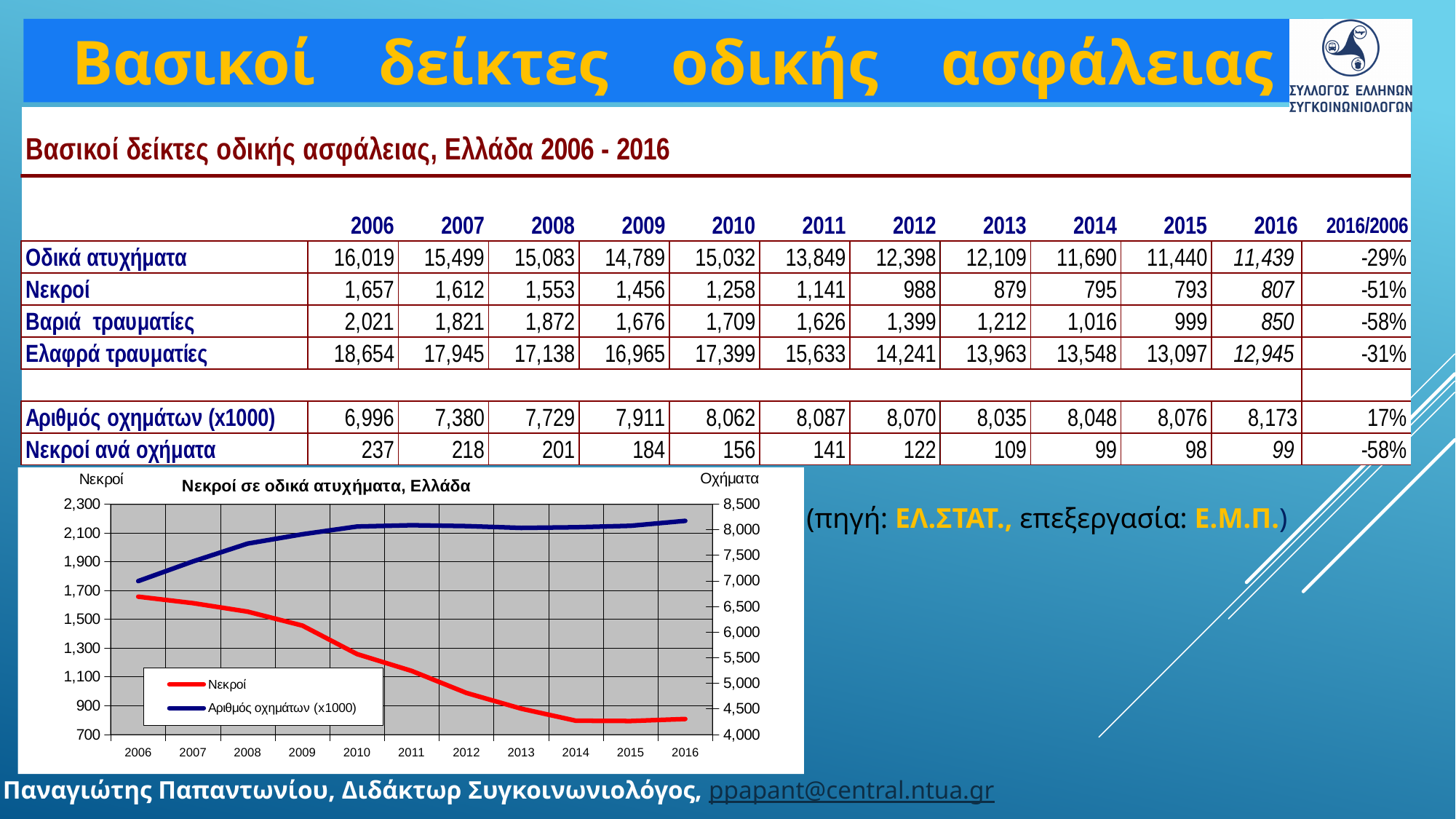
According to the slide, what is the value of Αριθμός οχημάτων (x1000) for 2016? 8,173 How many years are plotted along the x axis of the chart 'Νεκροί σε οδικά ατυχήματα, Ελλάδα'? 11 In the chart 'Νεκροί σε οδικά ατυχήματα, Ελλάδα', which year has the highest value for Νεκροί? 2006 In the chart 'Νεκροί σε οδικά ατυχήματα, Ελλάδα', is the value for Αριθμός οχημάτων (x1000) in 2006 greater or less than 7,500? less In the chart 'Νεκροί σε οδικά ατυχήματα, Ελλάδα', is the value for Νεκροί in 2016 greater or less than 900? less In the chart 'Νεκροί σε οδικά ατυχήματα, Ελλάδα', what colour is the Νεκροί line? red In the chart 'Νεκροί σε οδικά ατυχήματα, Ελλάδα', does the Αριθμός οχημάτων (x1000) line rise or fall from 2006 to 2016? rise According to the slide, what is the value of Νεκροί for 2010? 1,258 In the chart 'Νεκροί σε οδικά ατυχήματα, Ελλάδα', does the Νεκροί line rise or fall from 2006 to 2016? fall How many series does the legend of the chart 'Νεκροί σε οδικά ατυχήματα, Ελλάδα' list? 2 What type of chart is shown at the bottom left of the slide? line chart In the chart 'Νεκροί σε οδικά ατυχήματα, Ελλάδα', which is larger: Νεκροί in 2008 or Νεκροί in 2012? 2008